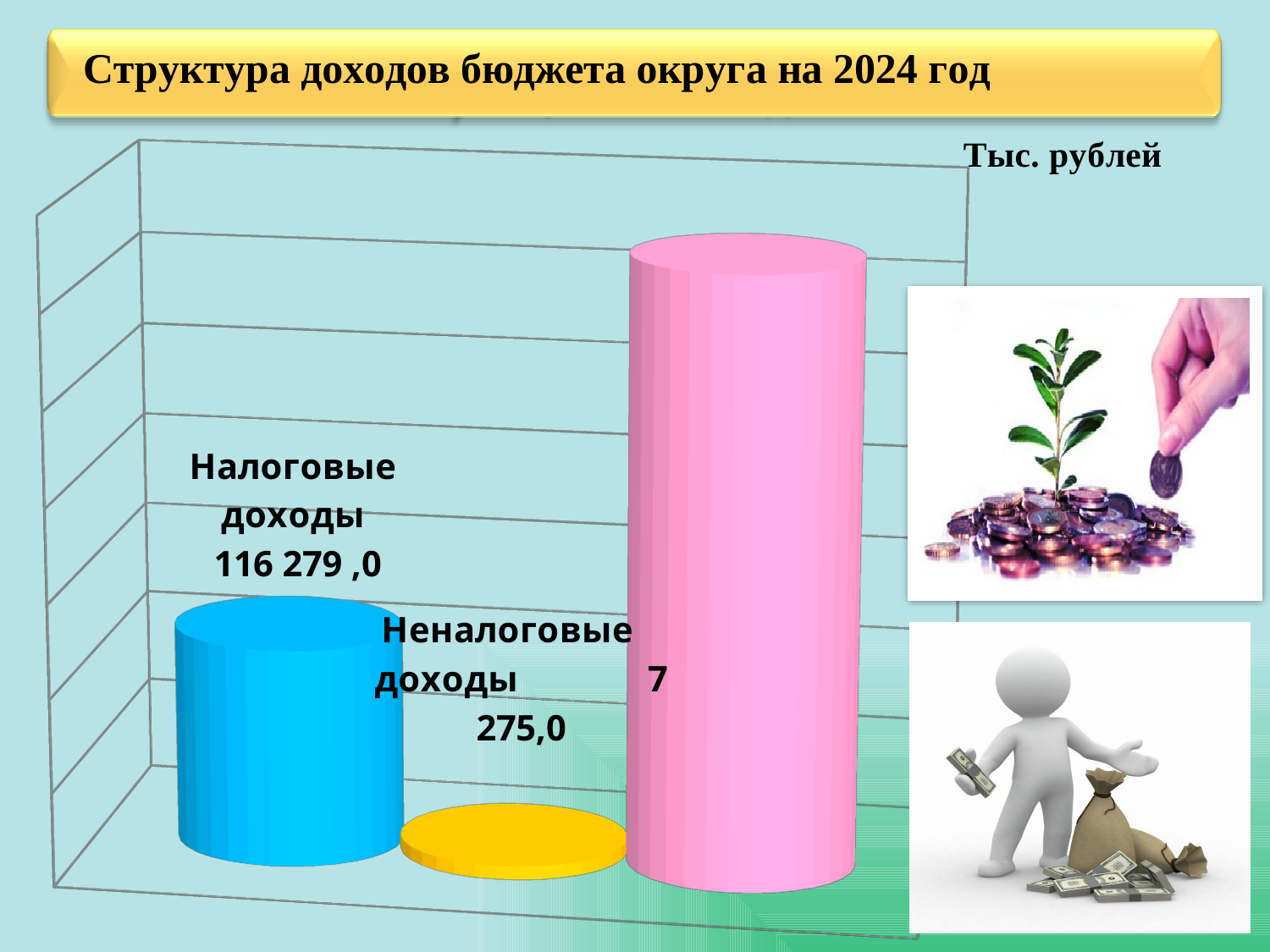
Which bar is the tallest on the chart: the blue, the yellow or the pink one? the pink bar What is the title of the slide? Структура доходов бюджета округа на 2024 год What is the difference between Налоговые доходы and Неналоговые доходы? 109 004,0 What kind of chart is shown on the slide? bar chart In what units are the values on the chart given? Тыс. рублей Is the bar for Налоговые доходы taller or shorter than the pink bar? shorter What is the value for Неналоговые доходы? 7 275,0 How many bars are shown on the chart? 3 Which labelled category has the lowest bar? Неналоговые доходы What is the value for Налоговые доходы? 116 279 ,0 Which is larger, Налоговые доходы or Неналоговые доходы? Налоговые доходы